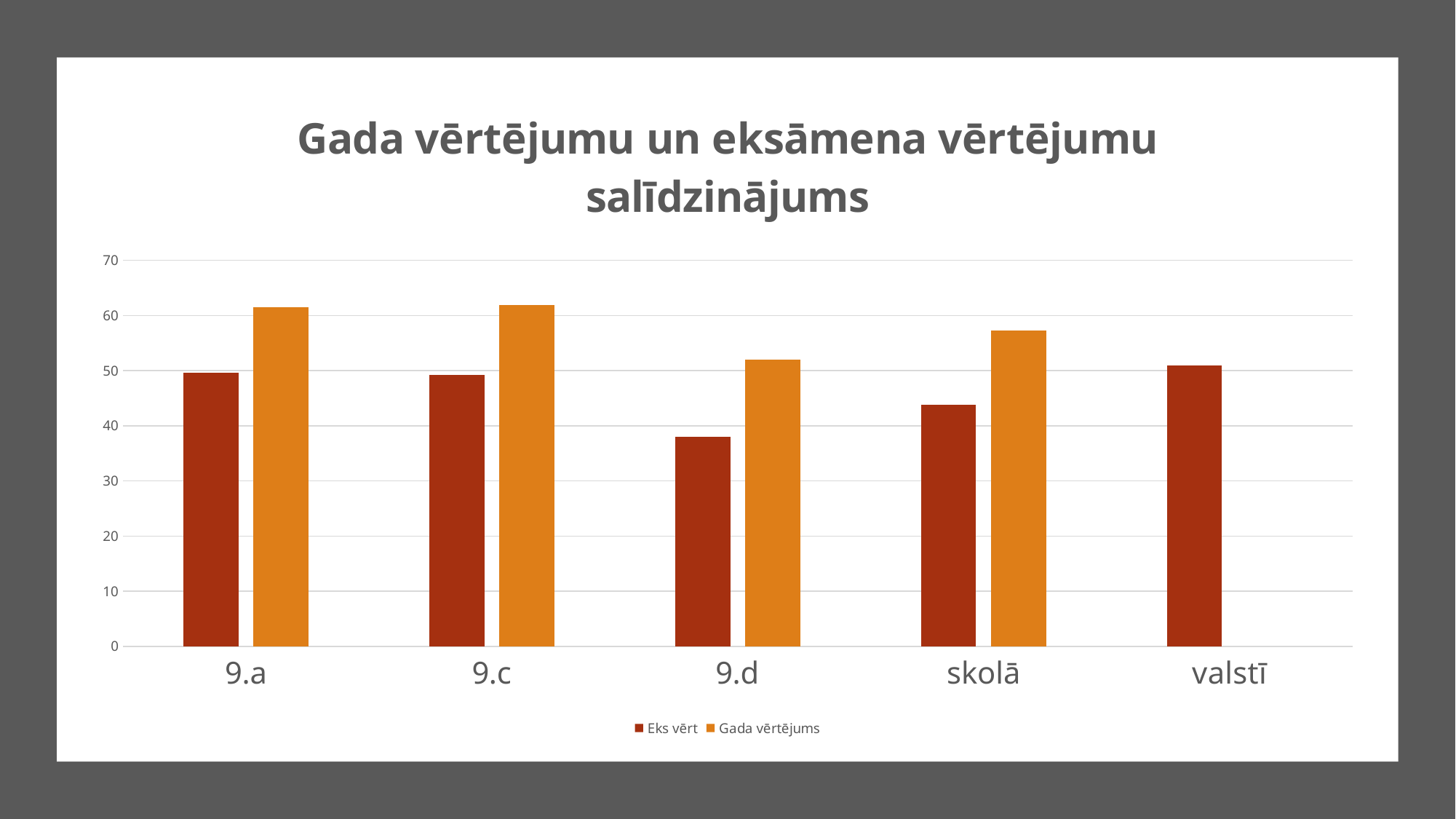
Is the Gada vērtējums value for 9.a greater or less than 60? greater How many categories are shown on the x axis? 5 How many series does the legend list? 2 Is the Eks vērt value for 9.d greater or less than 40? less Which category has the lowest Eks vērt value? 9.d Is the Eks vērt value for skolā greater or less than 50? less Which is larger: the Eks vērt value for 9.d or the Eks vērt value for skolā? skolā Which category has no Gada vērtējums bar? valstī For 9.a, which is larger: the Eks vērt value or the Gada vērtējums value? Gada vērtējums What kind of chart is shown on the slide? bar chart Which category has the lowest Gada vērtējums value? 9.d